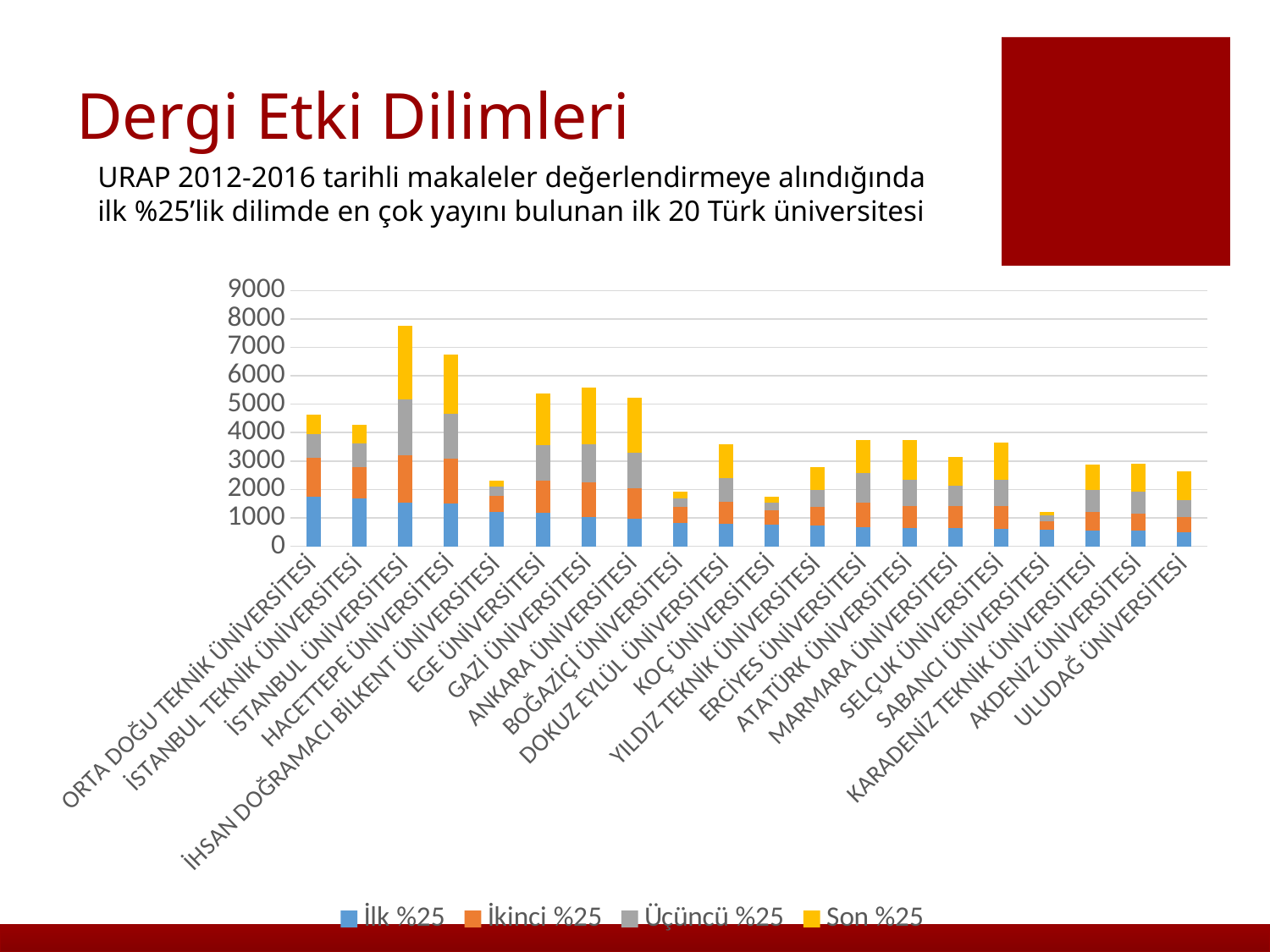
How many series does the chart legend list? 4 How many universities are shown on the x axis of the chart? 20 What kind of chart is shown on the slide? stacked bar chart Which university has the tallest stacked bar in the chart? İSTANBUL ÜNİVERSİTESİ Is the total stacked bar for EGE ÜNİVERSİTESİ greater or less than 3000? greater Which legend entry is shown in yellow? Son %25 Which university has the shortest stacked bar in the chart? SABANCI ÜNİVERSİTESİ Which has the taller stacked bar, HACETTEPE ÜNİVERSİTESİ or ANKARA ÜNİVERSİTESİ? HACETTEPE ÜNİVERSİTESİ Is the total stacked bar for SABANCI ÜNİVERSİTESİ greater or less than 2000? less Does the İlk %25 series (blue segments) rise or fall from left to right along the x axis? fall Is the total stacked bar for İSTANBUL ÜNİVERSİTESİ greater or less than 7000? greater